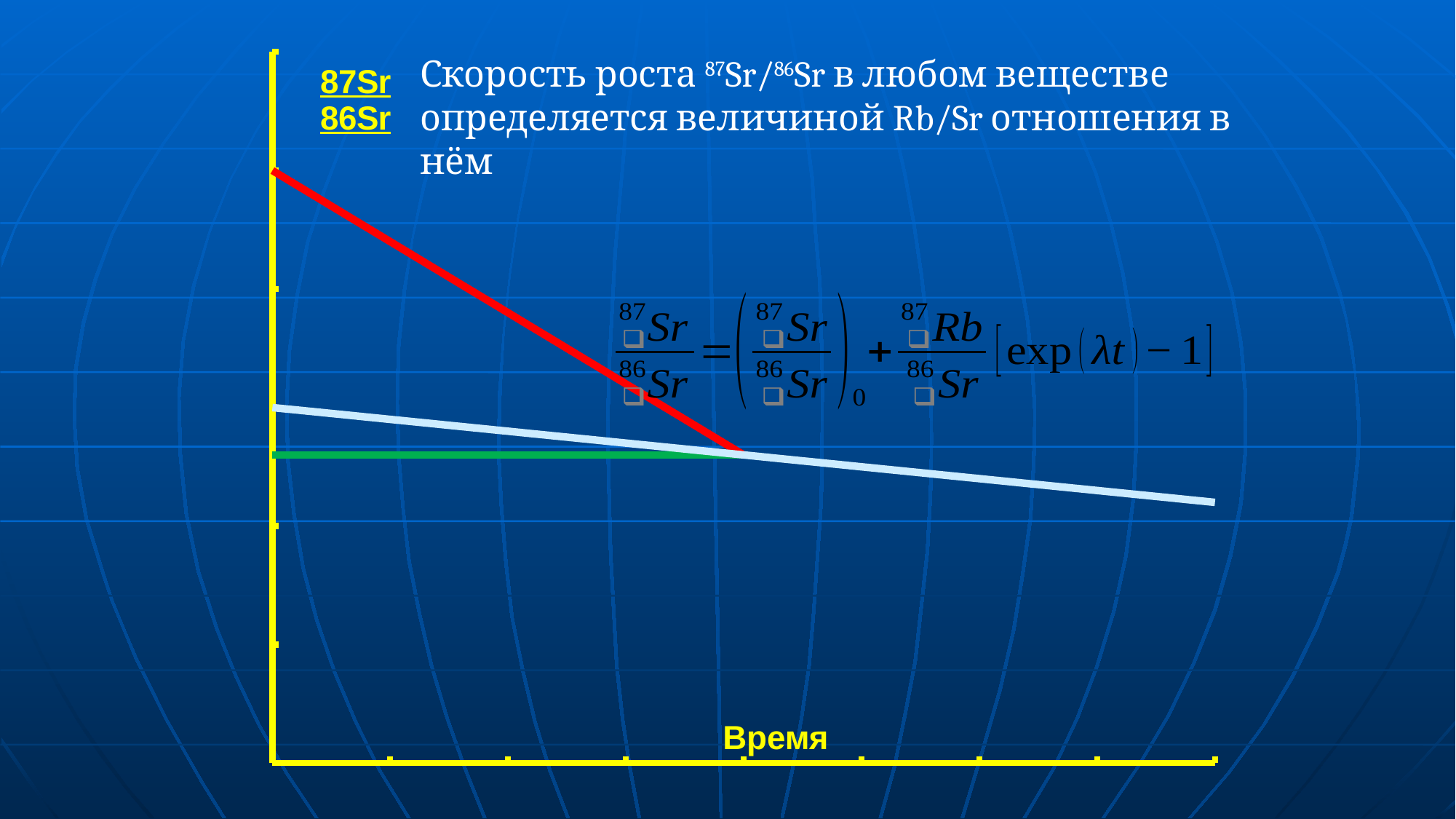
Which line starts highest on the vertical axis at the left edge of the chart: the red, light blue, or green line? red How many lines are plotted on the chart? 3 Does the green line rise, fall, or stay flat along the time axis? stay flat Which line has the steepest slope: the red, light blue, or green line? red Does the red line rise or fall from left to right along the time axis? fall Which line extends furthest to the right along the time axis? light blue What is the label of the horizontal axis of the chart? Время Does the light blue line rise or fall from left to right along the time axis? fall What kind of chart is shown on the slide? line chart What ratio is labelled on the vertical axis of the chart? 87Sr/86Sr